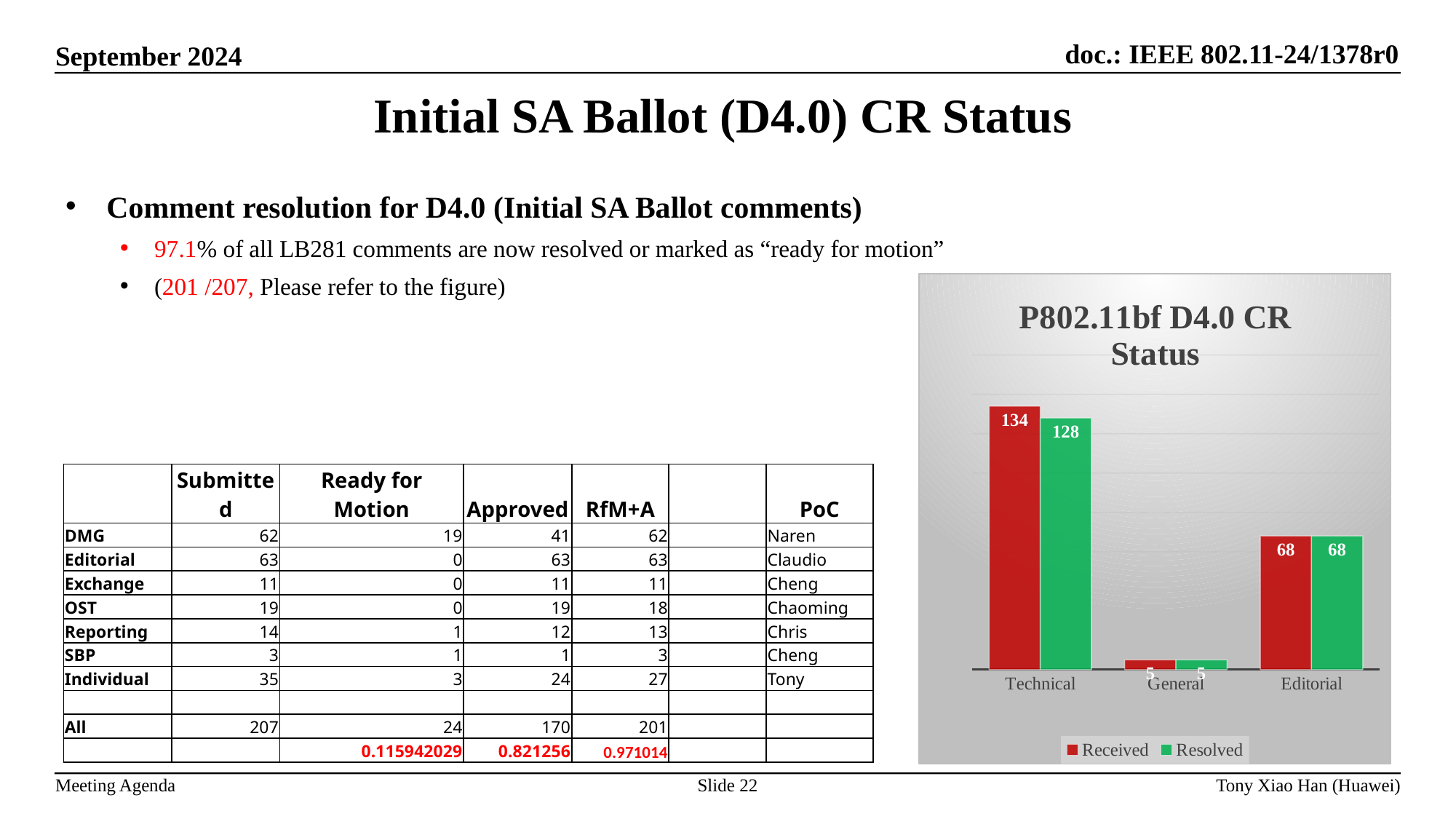
How many series does the legend of the P802.11bf D4.0 CR Status chart list? 2 Which category has the highest Received value in the P802.11bf D4.0 CR Status chart? Technical What kind of chart is the P802.11bf D4.0 CR Status chart? bar chart What is the Resolved value for General in the P802.11bf D4.0 CR Status chart? 5 What is the difference between the Received and Resolved values for Technical in the P802.11bf D4.0 CR Status chart? 6 Which category has the lowest Resolved value in the P802.11bf D4.0 CR Status chart? General What is the Received value for Technical in the P802.11bf D4.0 CR Status chart? 134 What is the Resolved value for Technical in the P802.11bf D4.0 CR Status chart? 128 How many categories are shown on the x axis of the P802.11bf D4.0 CR Status chart? 3 What colour are the Resolved bars in the P802.11bf D4.0 CR Status chart? green In the P802.11bf D4.0 CR Status chart, is the Received value for Technical or for Editorial larger? Technical What is the Received value for Editorial in the P802.11bf D4.0 CR Status chart? 68